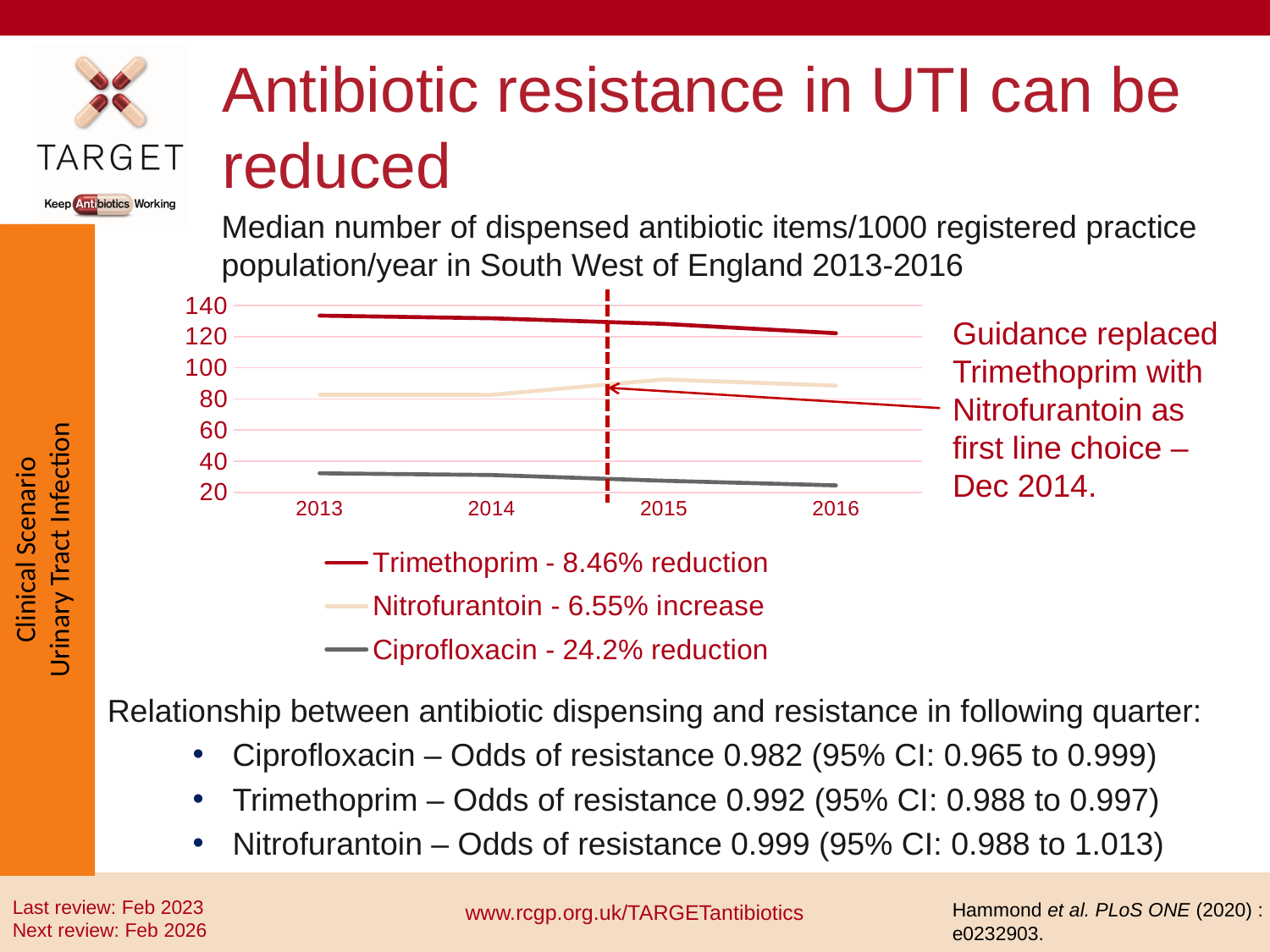
Is the Nitrofurantoin value larger in 2013 or in 2015? 2015 What kind of chart is shown on the slide? line chart Which antibiotic has the highest median number of dispensed items across all years shown? Trimethoprim According to the legend, what percentage change is given for Nitrofurantoin? 6.55% increase Does the Trimethoprim line rise or fall from 2013 to 2016? fall How many series does the chart's legend list? 3 Does the Ciprofloxacin line rise or fall from 2013 to 2016? fall Is the value for Ciprofloxacin in 2016 greater or less than 40? less Is the value for Nitrofurantoin in 2013 greater or less than 100? less How many years are shown along the x axis of the chart? 4 Is the value for Trimethoprim in 2013 greater or less than 120? greater Which antibiotic has the lowest median number of dispensed items across all years shown? Ciprofloxacin